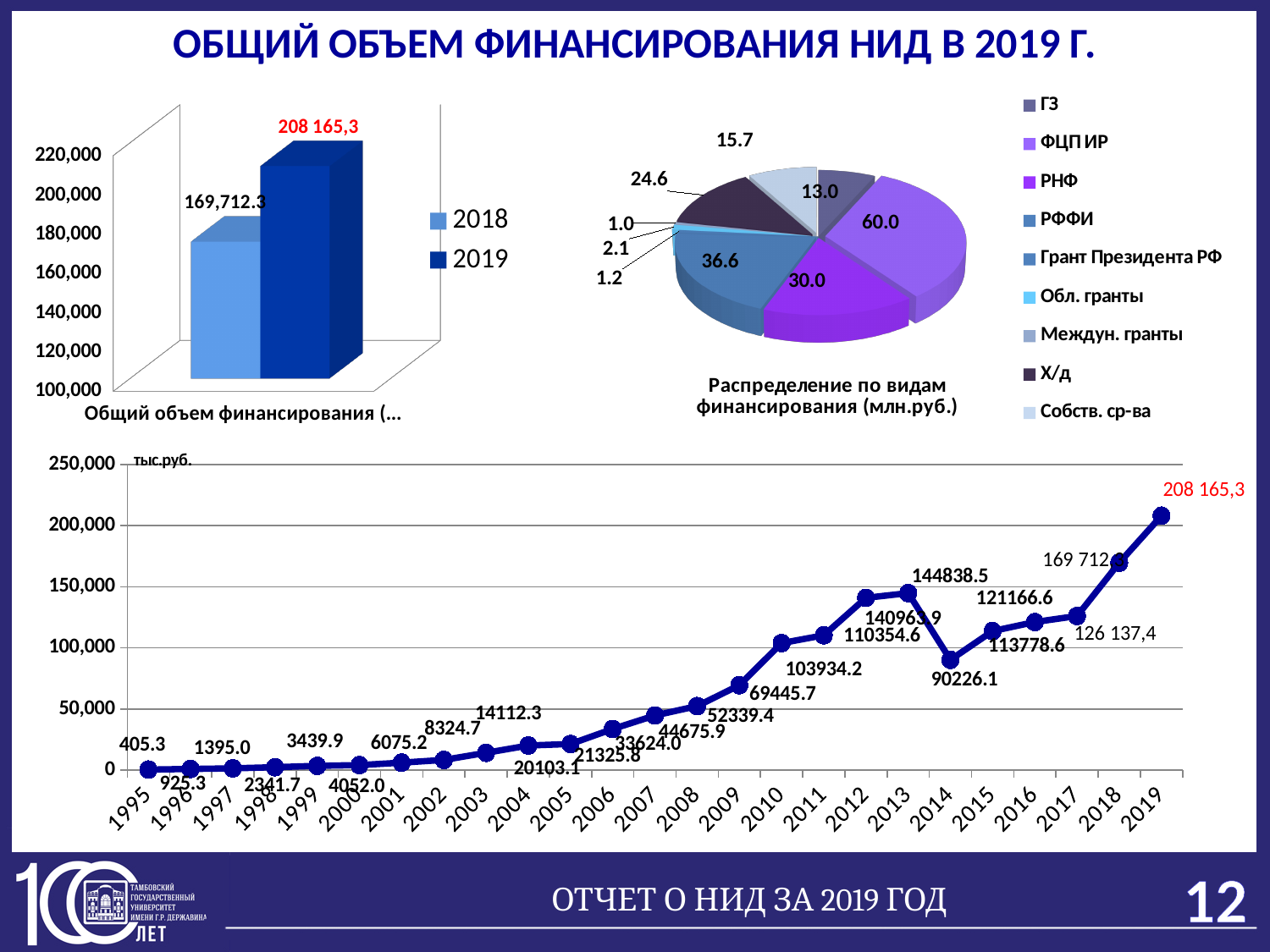
How many years are plotted on the x axis of the bottom line chart? 25 In the bottom line chart, what is the value for 2014? 90226.1 In the bottom line chart, which year has a larger value, 2013 or 2014? 2013 In the top-left bar chart, what is the value for 2018? 169,712.3 What kind of chart is the top-left chart on the slide? bar chart How many series does the legend of the top-left bar chart list? 2 How many categories does the legend of the pie chart 'Распределение по видам финансирования (млн.руб.)' list? 9 In the bottom line chart, what is the value for 1995? 405.3 In the pie chart 'Распределение по видам финансирования (млн.руб.)', which category has the largest slice? ФЦП ИР In the top-left bar chart, what is the value for 2019? 208 165,3 In the pie chart 'Распределение по видам финансирования (млн.руб.)', what is the value for РФФИ? 36.6 In the bottom line chart, do the values generally rise or fall from 1995 to 2019? rise